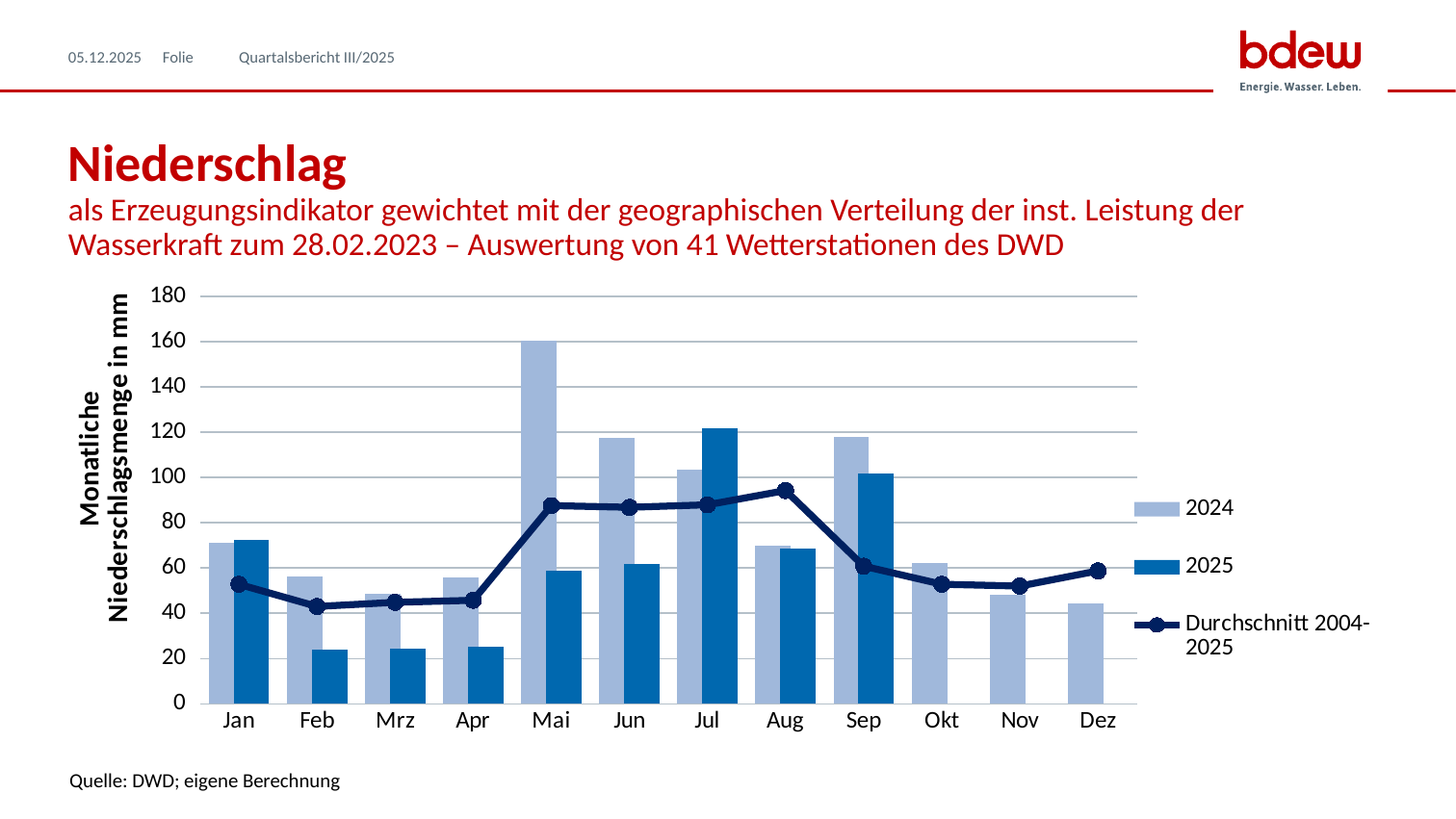
For Sep, which is larger: the 2024 value or the 2025 value? 2024 In which month is the 2025 value highest? Jul Do the 2025 values rise or fall from Apr to Jul? rise For Jul, which is larger: the 2024 value or the 2025 value? 2025 How many series does the legend list? 3 Is the 2025 value for Feb greater or less than 40? less How many months are shown on the x axis? 12 In which month is the 2024 value highest? Mai Is the 2025 value for Jul greater or less than 100? greater Is the Durchschnitt 2004-2025 value for Aug greater or less than 80? greater What kind of chart is shown on the slide? A bar chart combined with a line